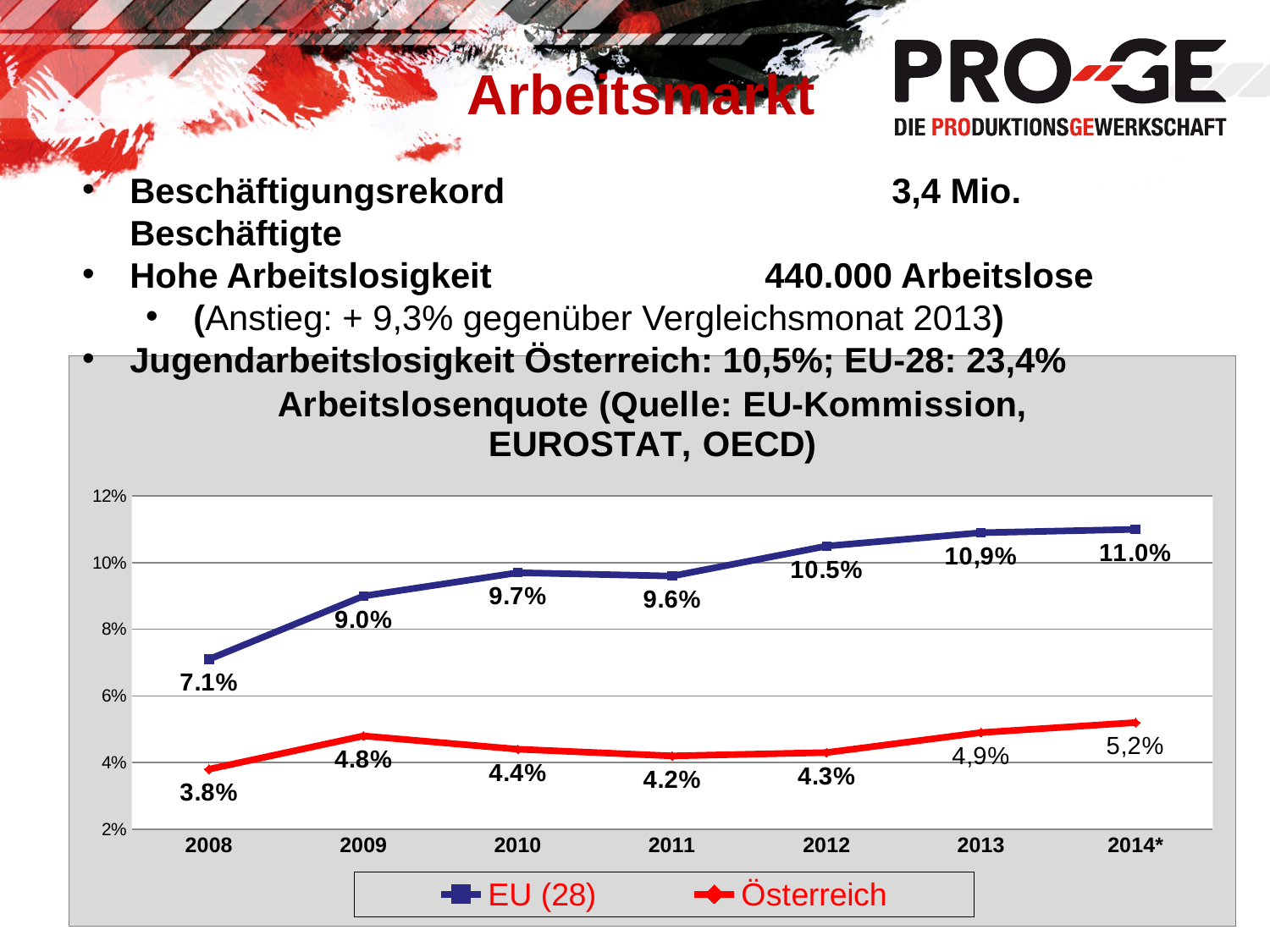
How many series does the legend list? 2 Which is larger, the Österreich value in 2009 or in 2012? 2009 In which year is the EU (28) value lowest? 2008 What is the EU (28) unemployment rate for 2010? 9.7% What is the Österreich value for 2014*? 5,2% What is the difference between the EU (28) and Österreich values in 2008? 3.3 percentage points What is the Österreich unemployment rate for 2011? 4.2% How many years are shown on the x axis? 7 Does the EU (28) line generally rise or fall from 2008 to 2014*? rise In which year is the Österreich value highest? 2014* What is the EU (28) value for 2013? 10,9% What type of chart is shown on the slide? line chart